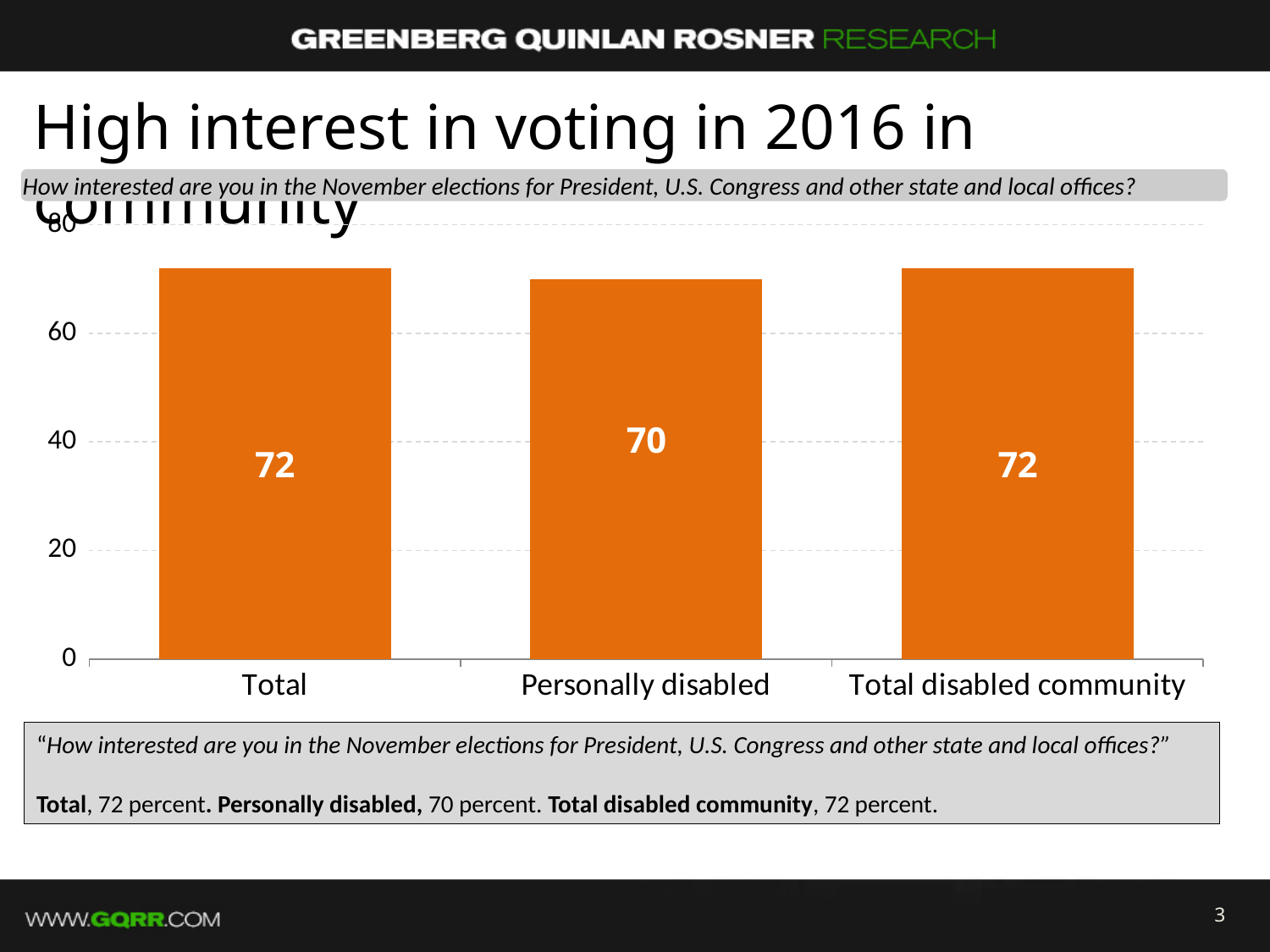
What colour are the bars in the chart? orange Is the value for Total greater or less than 80? less What is the value for Personally disabled? 70 Which category has the lowest value? Personally disabled What is the value for Total? 72 Which is larger, the value for Total disabled community or the value for Personally disabled? Total disabled community What is the value for Total disabled community? 72 Is the value for Personally disabled greater or less than 60? greater How many categories are shown in the chart? 3 What is the highest value shown on the vertical axis? 80 What kind of chart is shown on the slide? bar chart What is the difference between the values for Total and Personally disabled? 2